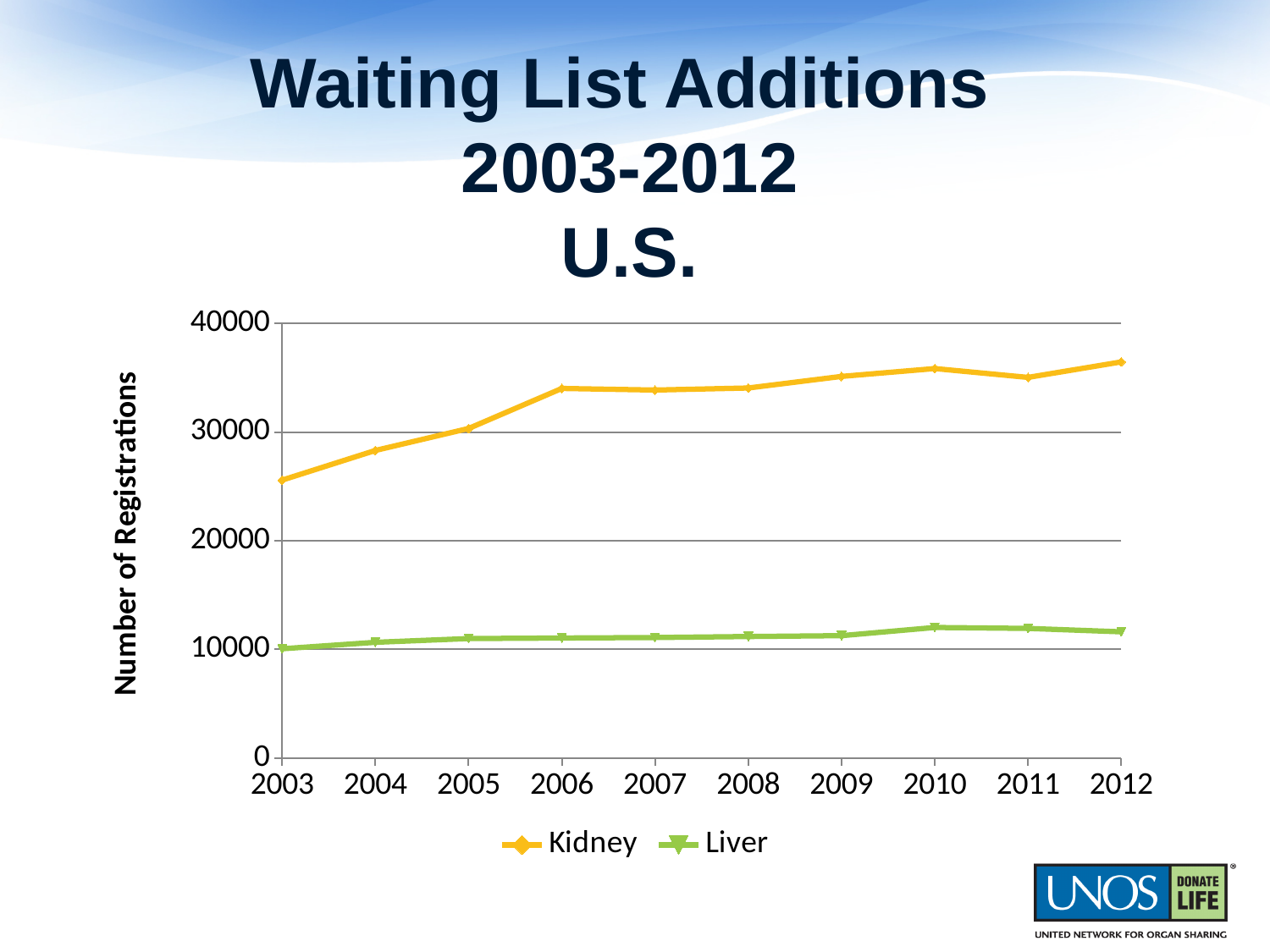
What kind of chart is shown on the slide? line chart In which year is the Liver value lowest? 2003 Which series has the higher value in 2008, Kidney or Liver? Kidney Is the Liver value for 2010 greater or less than 10000? greater Does the Kidney series generally rise or fall from 2003 to 2012? rise Is the Kidney value for 2006 greater or less than 30000? greater Is the Kidney value for 2003 greater or less than 30000? less How many years are plotted along the x axis? 10 How many series does the legend list? 2 In which year is the Kidney value lowest? 2003 What is the label on the y axis of the chart? Number of Registrations